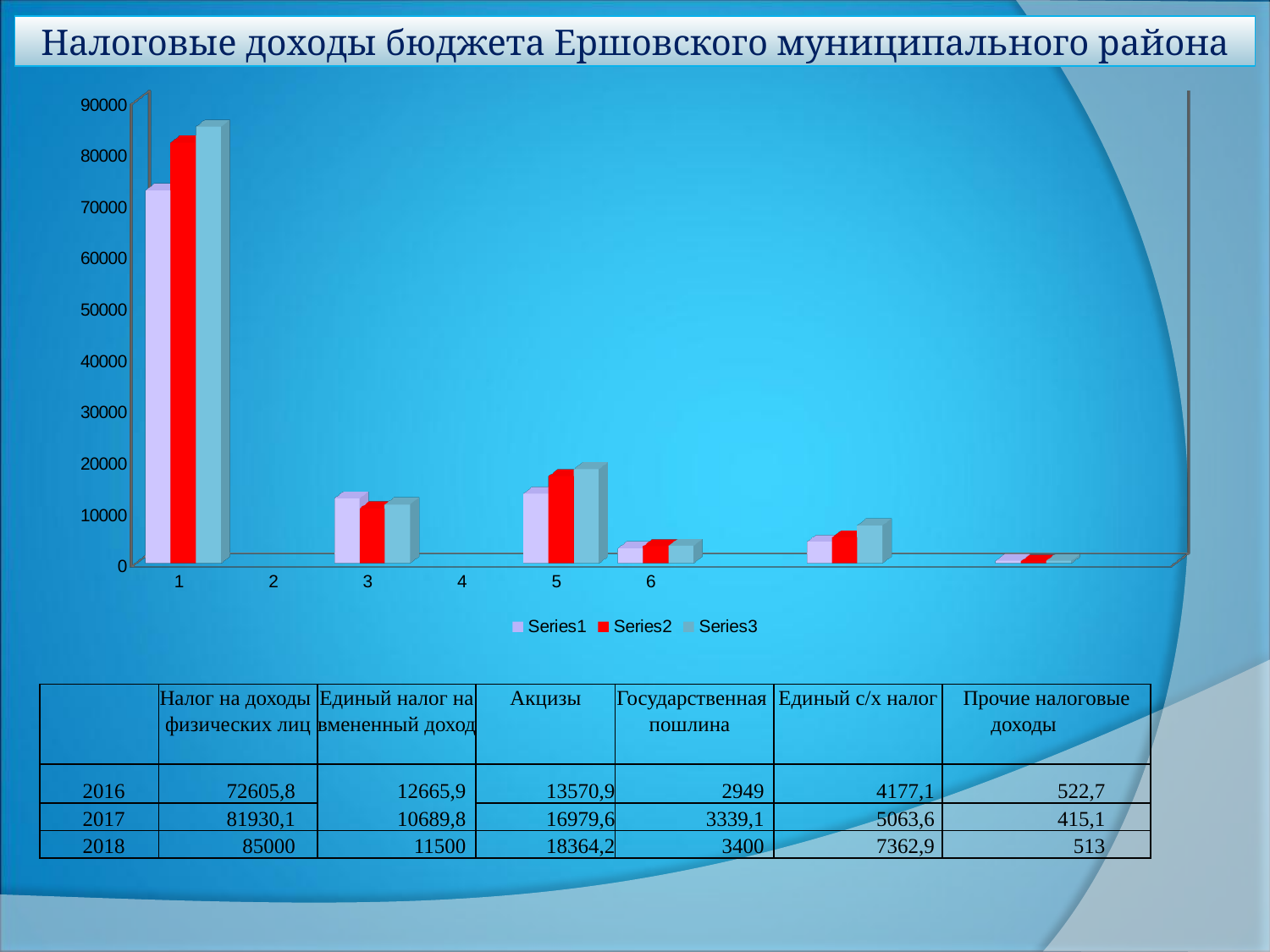
Is the Series2 value for category 5 greater or less than 10000? greater For category 5, which is larger: Series1 or Series3? Series3 How many series does the chart legend list? 3 Is the Series1 value for category 3 greater or less than 20000? less What kind of chart is shown on the slide? bar chart How many groups of bars are plotted on the chart? 6 What are the entries in the chart legend? Series1, Series2, Series3 Is the Series1 value for category 1 greater or less than 80000? less Which category on the x axis has the tallest bars? 1 What is the title of the slide containing the chart? Налоговые доходы бюджета Ершовского муниципального района For category 1, which is larger: Series1 or Series2? Series2